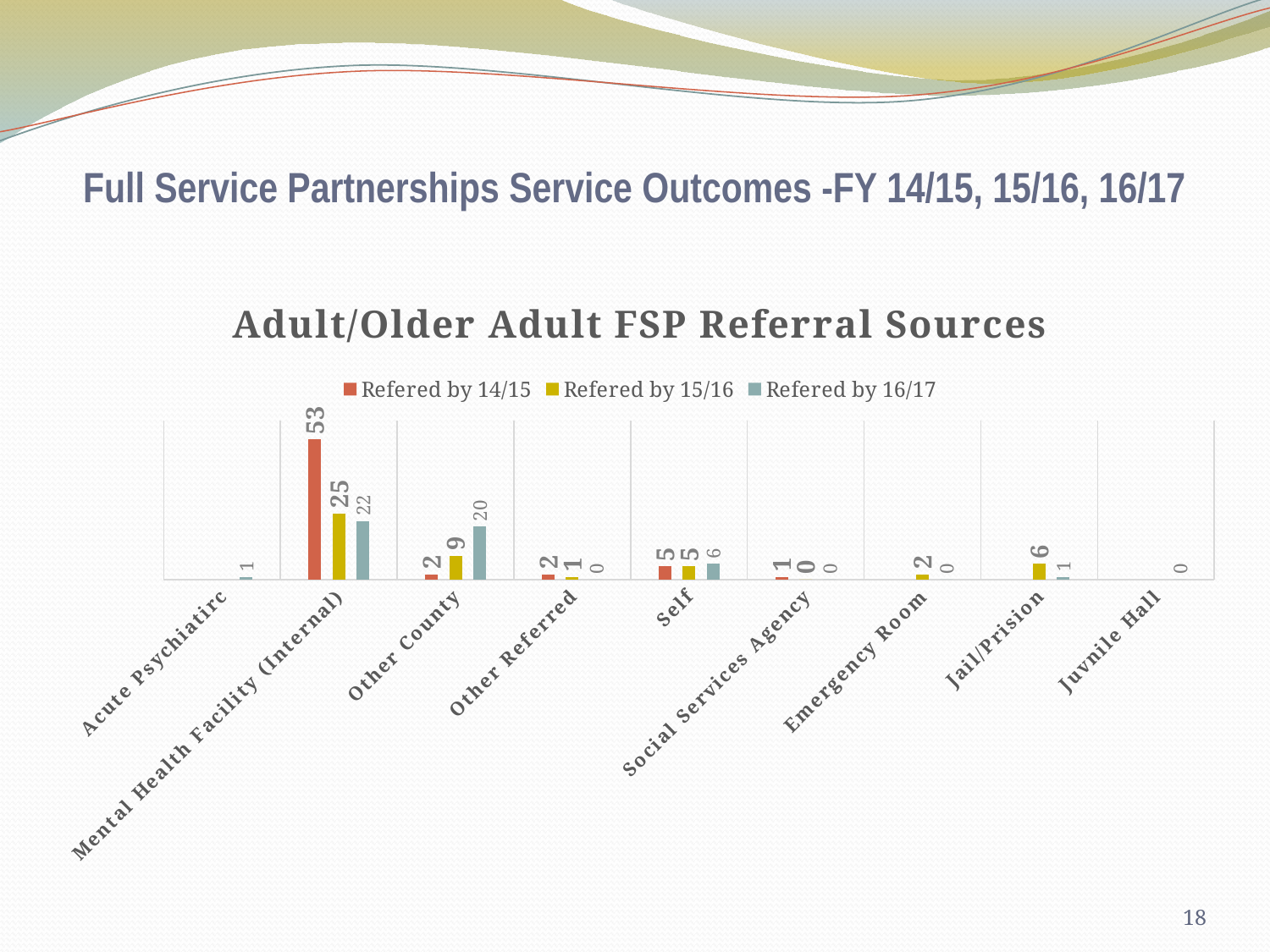
What kind of chart is shown on the slide? Bar chart How many series does the legend list? 3 What is the difference between the Refered by 14/15 and Refered by 15/16 values for Mental Health Facility (Internal)? 28 What is the value for Self in the Refered by 16/17 series? 6 How many referral source categories are shown on the x axis? 9 What is the title of the chart? Adult/Older Adult FSP Referral Sources For Other County, which series has the larger value: Refered by 15/16 or Refered by 16/17? Refered by 16/17 Which referral source has the highest value in the Refered by 14/15 series? Mental Health Facility (Internal) What is the value for Other County in the Refered by 16/17 series? 20 What is the value for Mental Health Facility (Internal) in the Refered by 14/15 series? 53 What is the value for Jail/Prision in the Refered by 15/16 series? 6 What is the total of the three series values for Other Referred? 3